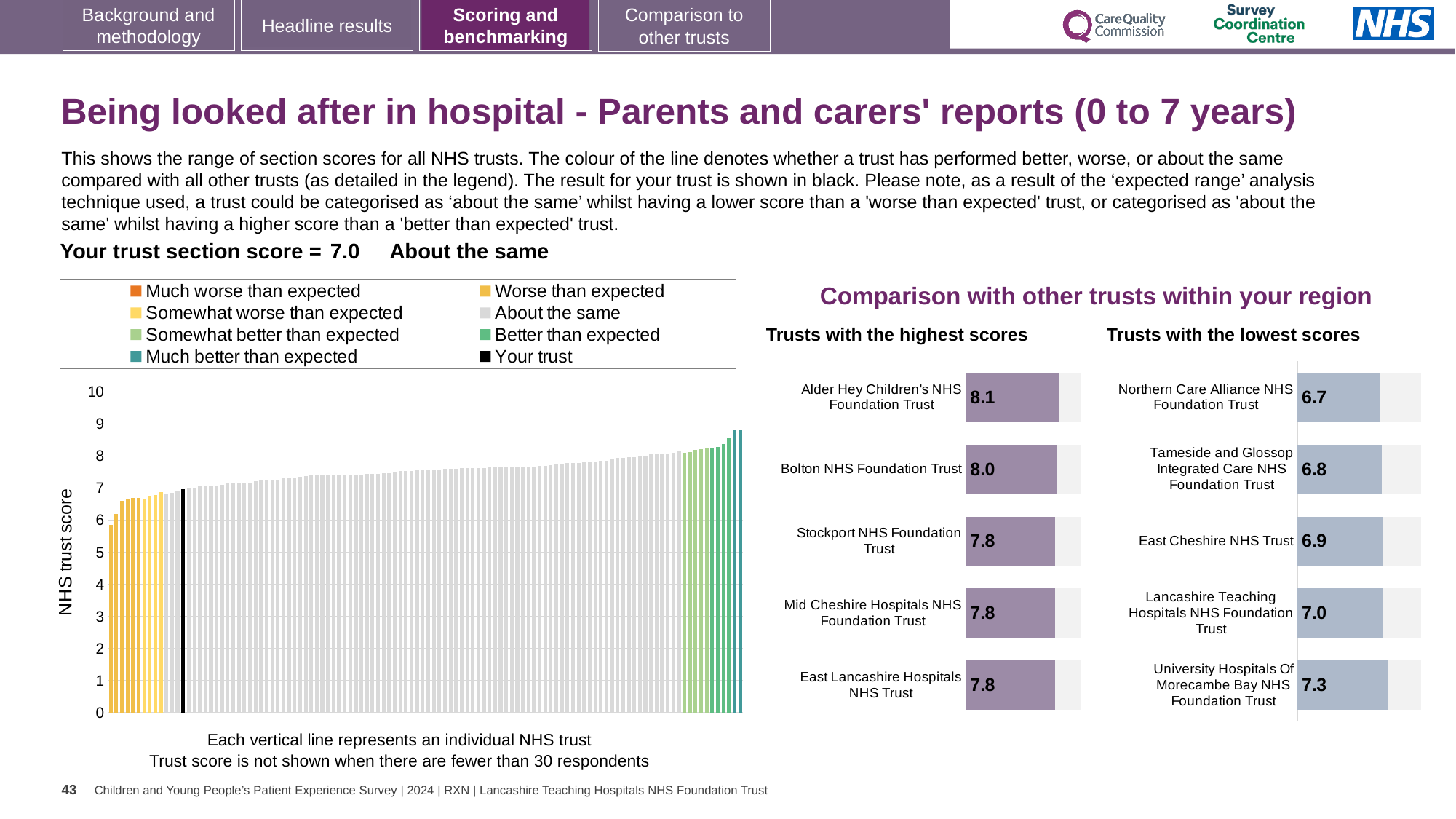
In the 'Trusts with the lowest scores' chart, what is the score for Tameside and Glossop Integrated Care NHS Foundation Trust? 6.8 In the 'Trusts with the highest scores' chart, how many trusts are shown? 5 In the main chart on the left showing all NHS trusts, what is the score of the trust shown in black (your trust)? 7.0 In the 'Trusts with the highest scores' chart, which trust has the highest score? Alder Hey Children's NHS Foundation Trust In the 'Trusts with the lowest scores' chart, what is the score for East Cheshire NHS Trust? 6.9 In the 'Trusts with the lowest scores' chart, which trust has the lowest score? Northern Care Alliance NHS Foundation Trust In the 'Trusts with the lowest scores' chart, what is the difference between the scores of University Hospitals Of Morecambe Bay NHS Foundation Trust and Northern Care Alliance NHS Foundation Trust? 0.6 How many entries does the legend of the main chart on the left list? 8 In the main chart on the left showing all NHS trusts, do the values rise or fall from left to right? rise In the 'Trusts with the highest scores' chart, which has the larger score: Alder Hey Children's NHS Foundation Trust or Stockport NHS Foundation Trust? Alder Hey Children's NHS Foundation Trust In the 'Trusts with the highest scores' chart, what is the score for Alder Hey Children's NHS Foundation Trust? 8.1 In the main chart on the left showing all NHS trusts, is the value of the rightmost (highest) bar greater or less than 8? greater